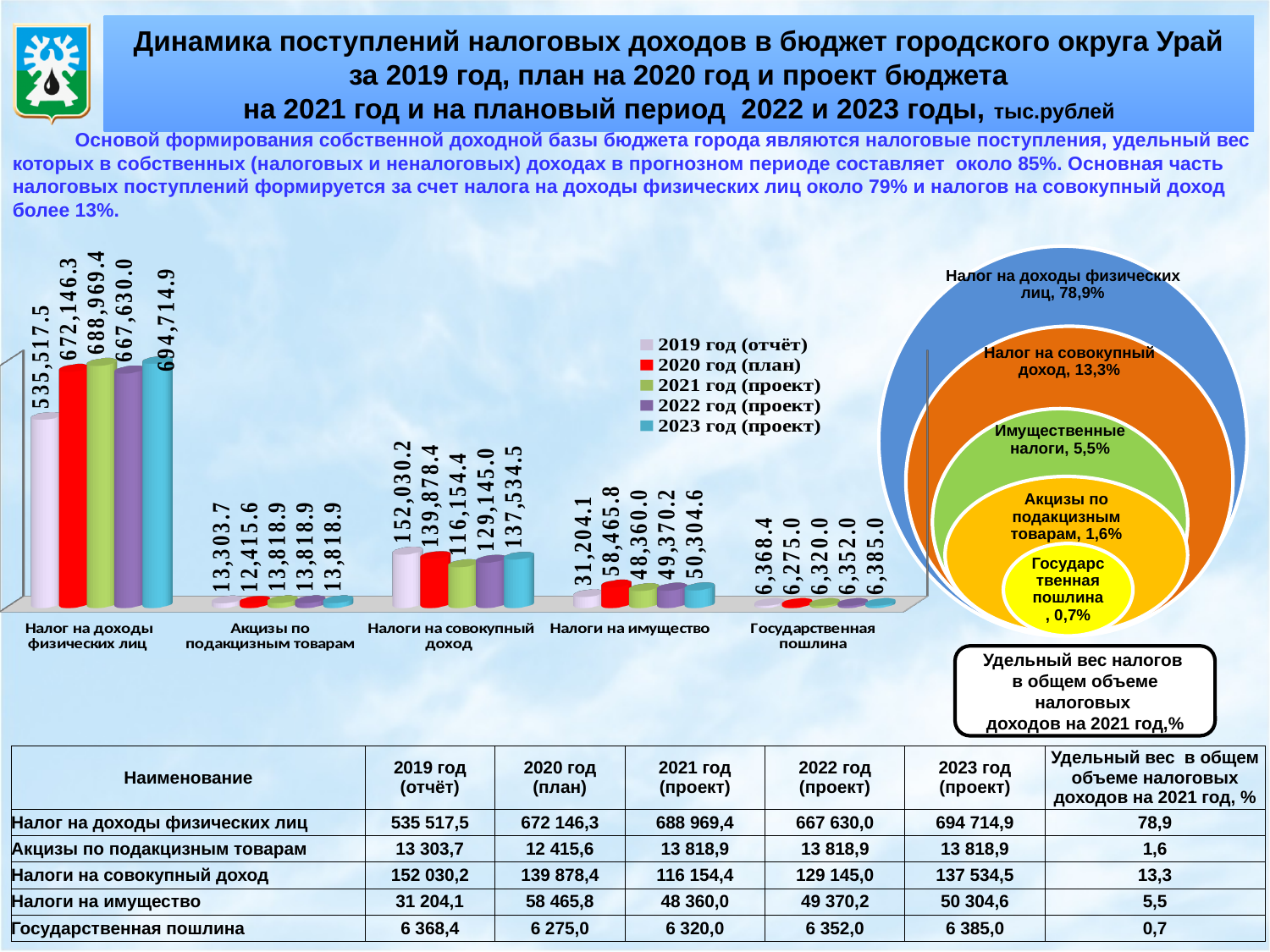
On the left bar chart, what is the difference between the 2023 год (проект) and 2019 год (отчёт) values for Налог на доходы физических лиц? 159,197.4 What kind of chart is the chart on the left of the slide? bar chart On the left bar chart, what is the value for Налоги на совокупный доход in 2021 год (проект)? 116,154.4 On the right nested-circle diagram, what share is shown for Налог на совокупный доход? 13,3% How many series does the legend of the left bar chart list? 5 On the left bar chart, for Налоги на имущество, which is larger: the 2020 год (план) value or the 2021 год (проект) value? 2020 год (план) On the left bar chart, what is the value for Государственная пошлина in 2023 год (проект)? 6,385.0 On the left bar chart, which category has the highest value for 2019 год (отчёт)? Налог на доходы физических лиц On the left bar chart, what is the value for Налог на доходы физических лиц in 2019 год (отчёт)? 535,517.5 How many categories are shown on the left bar chart? 5 On the left bar chart, what is the difference between the 2020 год (план) and 2019 год (отчёт) values for Налоги на имущество? 27,261.7 On the left bar chart, which category has the lowest value for 2023 год (проект)? Государственная пошлина